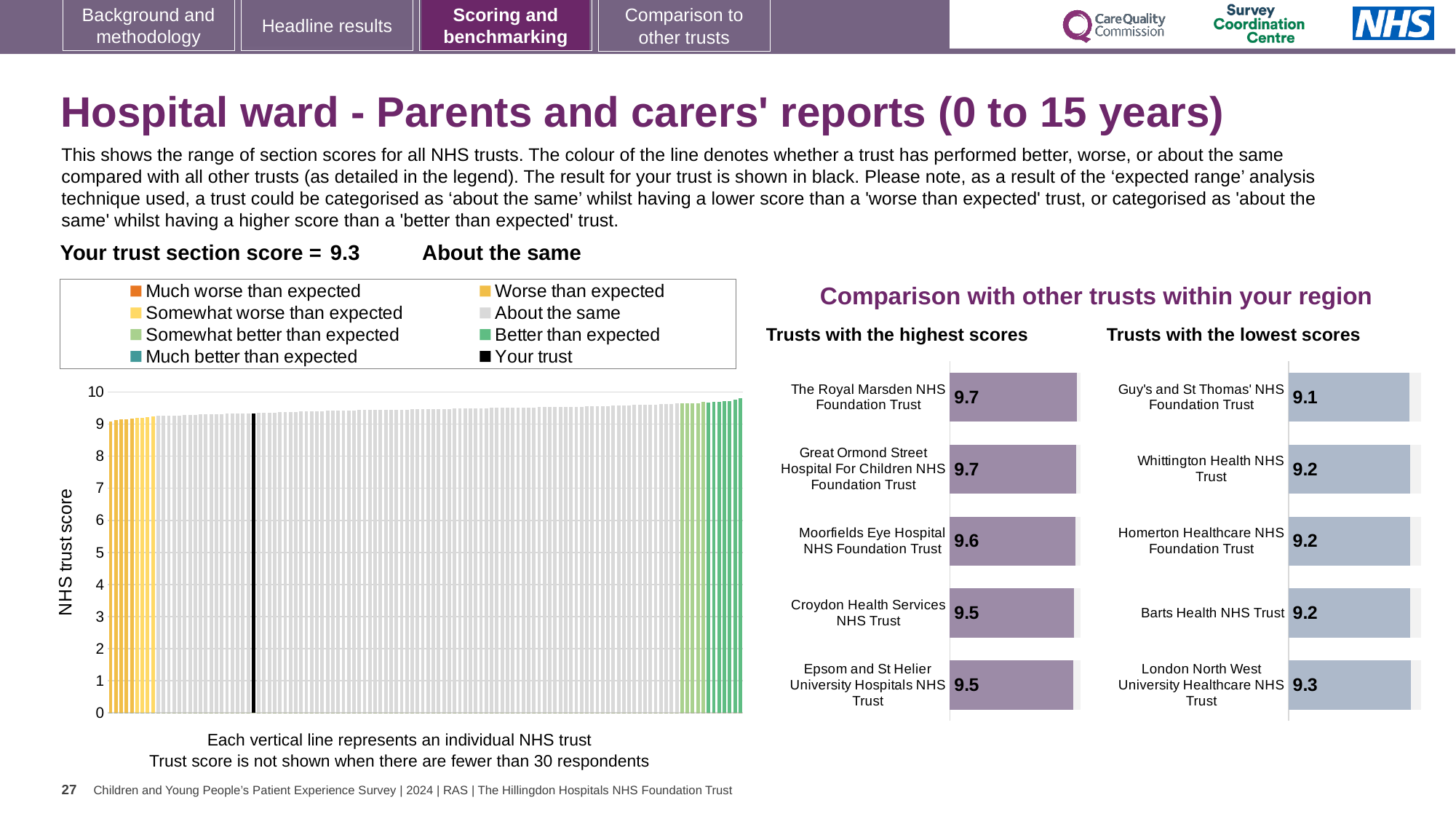
What kind of chart is the large chart on the left showing NHS trust scores? Bar chart How many entries does the legend of the left-hand NHS trust score chart list? 8 In the 'Trusts with the highest scores' chart, what is the score for Moorfields Eye Hospital NHS Foundation Trust? 9.6 In the 'Trusts with the lowest scores' chart, which trust has the highest score? London North West University Healthcare NHS Trust In the 'Trusts with the highest scores' chart, which has the higher score: Moorfields Eye Hospital NHS Foundation Trust or Croydon Health Services NHS Trust? Moorfields Eye Hospital NHS Foundation Trust In the 'Trusts with the lowest scores' chart, which trust has the lowest score? Guy's and St Thomas' NHS Foundation Trust In the 'Trusts with the highest scores' chart, what is the difference between the scores of The Royal Marsden NHS Foundation Trust and Croydon Health Services NHS Trust? 0.2 What is the y-axis label of the left-hand chart showing the range of section scores? NHS trust score In the 'Trusts with the lowest scores' chart, what is the difference between the scores of London North West University Healthcare NHS Trust and Guy's and St Thomas' NHS Foundation Trust? 0.2 In the 'Trusts with the lowest scores' chart, what is the score for Guy's and St Thomas' NHS Foundation Trust? 9.1 In the 'Trusts with the highest scores' chart, what is the score for The Royal Marsden NHS Foundation Trust? 9.7 How many trusts are shown in the 'Trusts with the highest scores' chart? 5